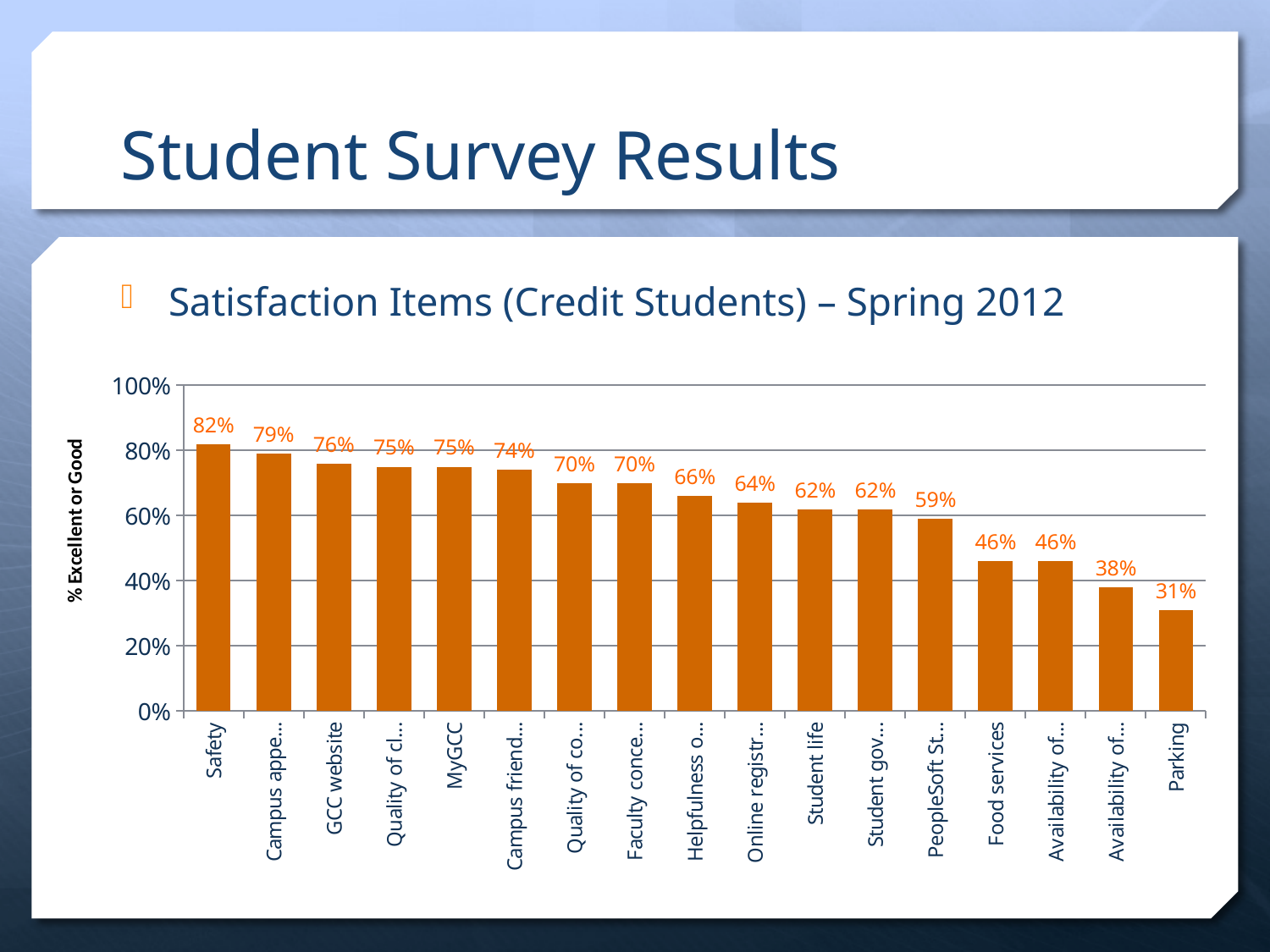
What is the value shown for Food services? 46% Which item has the highest percentage of Excellent or Good ratings? Safety What is the difference in percentage points between Safety and Parking? 51 What is the value shown for GCC website? 76% What is the value shown for MyGCC? 75% Which has a higher value, GCC website or Food services? GCC website How many items are plotted in the chart? 17 What kind of chart is shown on the slide? Bar chart What is the value shown for Student life? 62% Which item has the lowest percentage of Excellent or Good ratings? Parking Do the values rise or fall moving from left to right along the x axis? Fall What percentage of credit students rated Safety as Excellent or Good? 82%